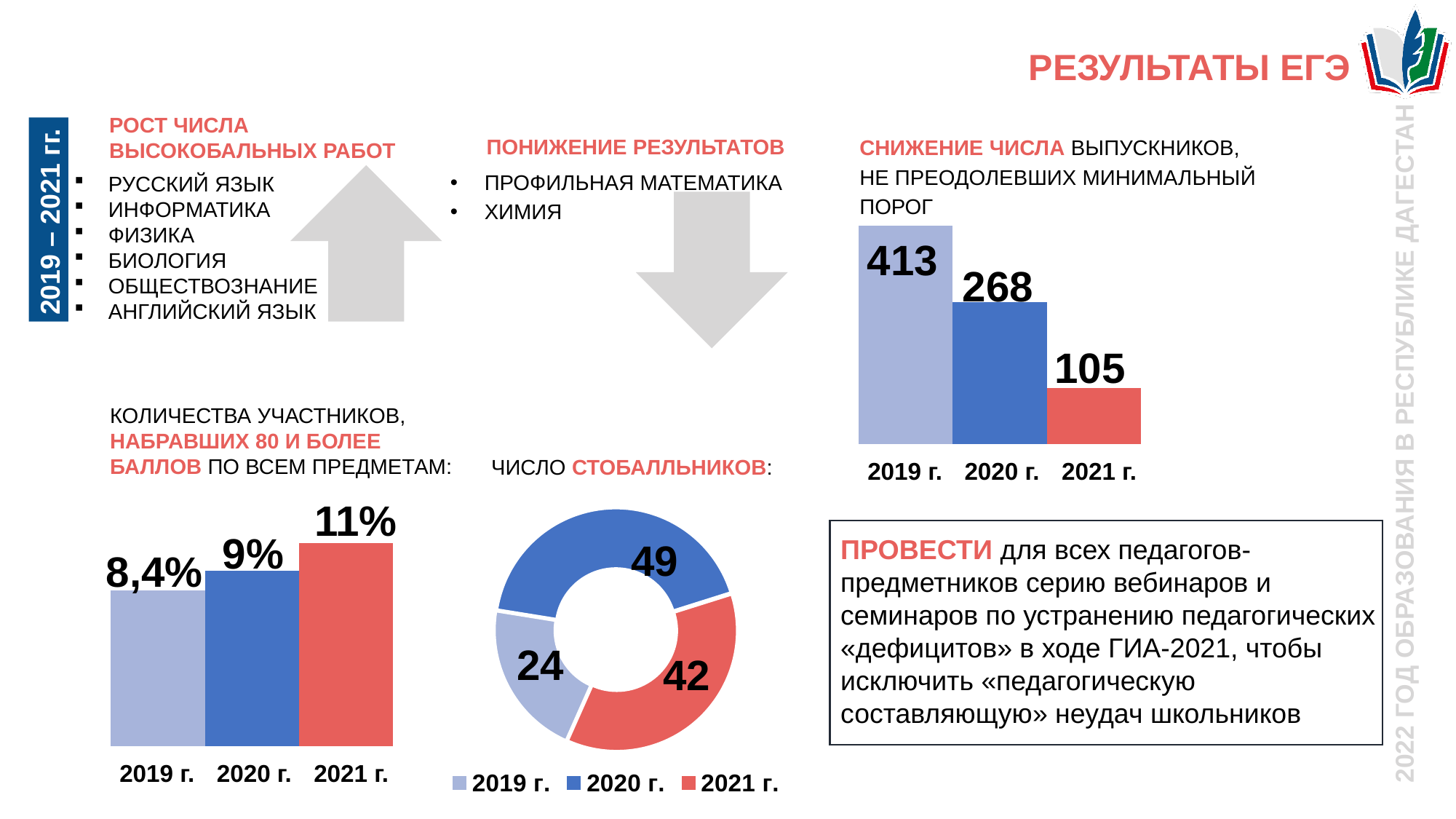
In the chart about graduates who did not pass the minimum threshold (top right), which year has the lowest value? 2021 г. How many entries does the legend of the chart of the number of 100-point scorers (ЧИСЛО СТОБАЛЛЬНИКОВ) list? 3 What kind of chart is the chart of participants scoring 80 or more points (bottom left)? bar chart In the chart about graduates who did not pass the minimum threshold (top right), what is the difference between the 2019 г. and 2021 г. values? 308 In the chart about graduates who did not pass the minimum threshold (top right), do the values rise or fall from 2019 г. to 2021 г.? fall In the chart of the number of 100-point scorers (ЧИСЛО СТОБАЛЛЬНИКОВ), which year has the smallest value? 2019 г. In the chart about graduates who did not pass the minimum threshold (top right), what is the value for 2020 г.? 268 In the chart of the number of 100-point scorers (ЧИСЛО СТОБАЛЛЬНИКОВ), which is larger: the value for 2020 г. or 2021 г.? 2020 г. In the chart of the number of 100-point scorers (ЧИСЛО СТОБАЛЛЬНИКОВ), what is the value for 2020 г.? 49 In the chart of participants scoring 80 or more points (bottom left), which year has the highest value? 2021 г. In the chart of participants scoring 80 or more points (bottom left), what is the value for 2019 г.? 8,4% In the chart of participants scoring 80 or more points (bottom left), what is the difference between the 2021 г. and 2020 г. values? 2%